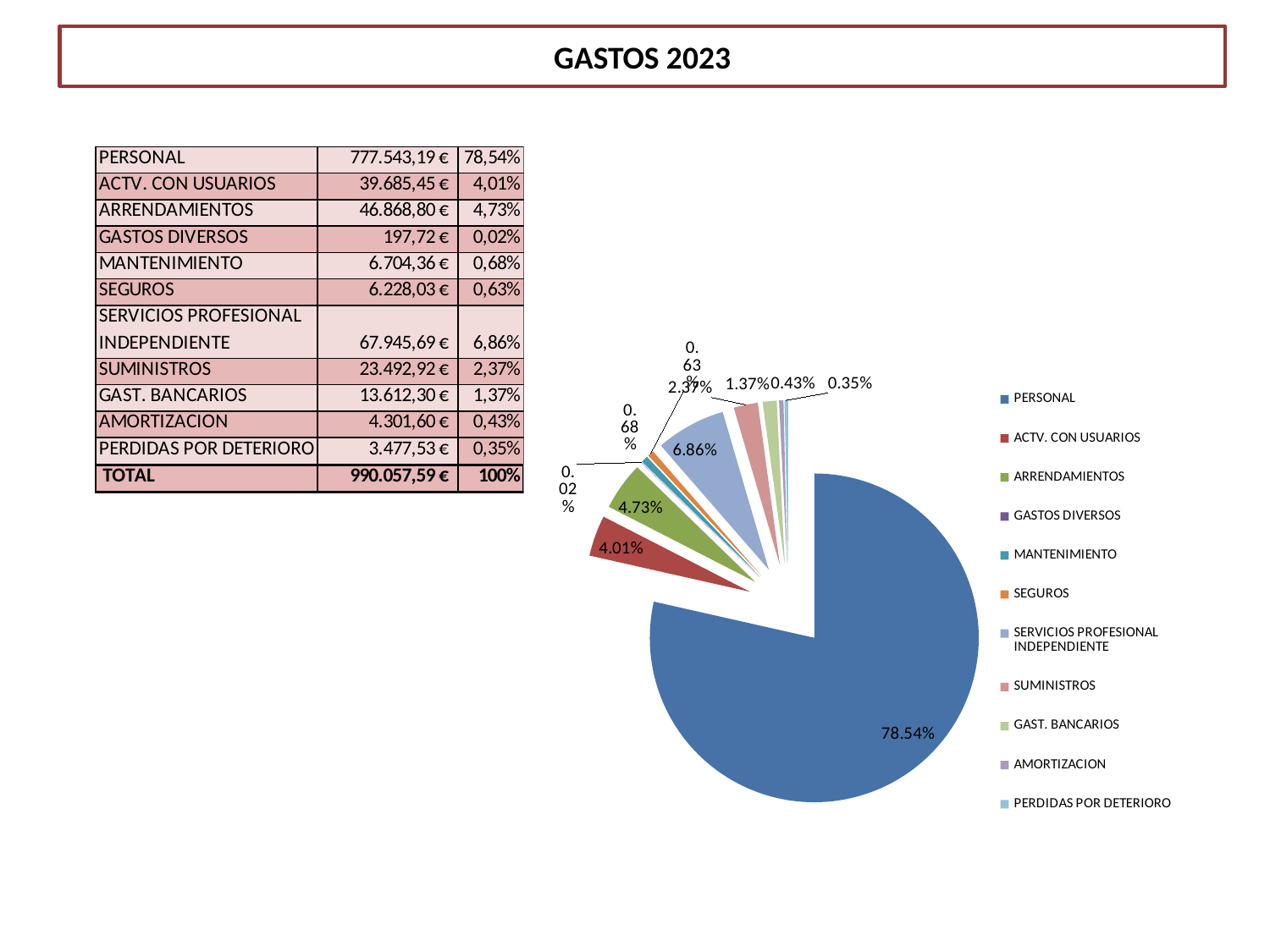
What is the data label for ACTV. CON USUARIOS in the pie chart? 4.01% What kind of chart is shown on the slide? pie chart How many categories does the legend of the pie chart list? 11 Which category has the smallest slice of the pie? GASTOS DIVERSOS Which category has the largest slice of the pie? PERSONAL Which slice is larger, ARRENDAMIENTOS or ACTV. CON USUARIOS? ARRENDAMIENTOS What share of the pie does PERSONAL represent? 78.54% What is the title shown at the top of the slide? GASTOS 2023 What is the data label for SERVICIOS PROFESIONAL INDEPENDIENTE in the pie chart? 6.86% What is the difference in percentage points between the SERVICIOS PROFESIONAL INDEPENDIENTE slice and the SUMINISTROS slice? 4.49% What is the data label for ARRENDAMIENTOS in the pie chart? 4.73% What is the data label for SUMINISTROS in the pie chart? 2.37%